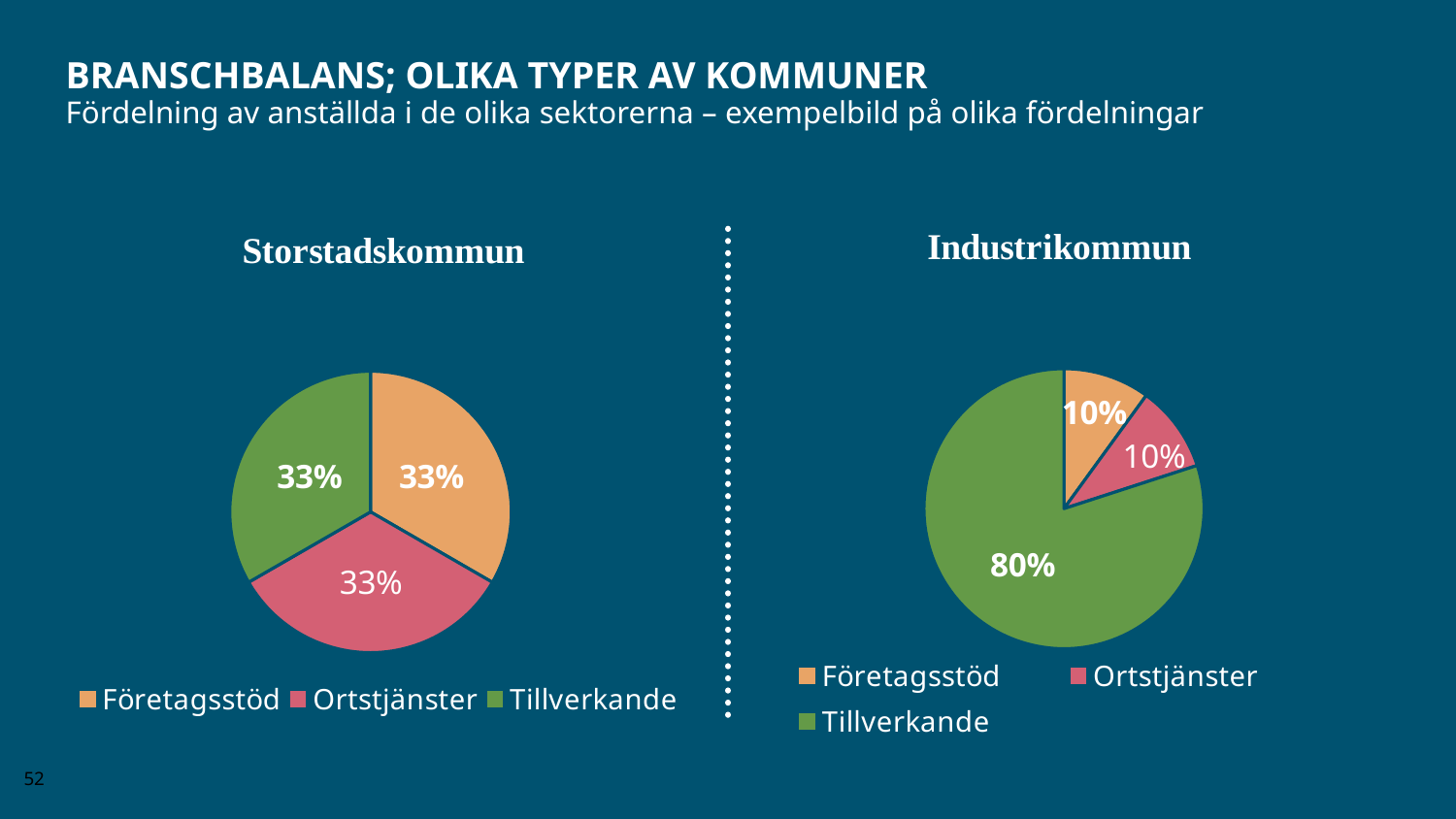
In the Storstadskommun chart, what share does Tillverkande have? 33% In the Industrikommun chart, which is larger, the share for Tillverkande or the share for Ortstjänster? Tillverkande In the Industrikommun chart, which colour represents Tillverkande? Green In the Industrikommun chart, which sector has the largest share? Tillverkande In the Industrikommun chart, what share does Ortstjänster have? 10% How many entries does the legend of the Storstadskommun chart list? 3 In the Industrikommun chart, what share does Företagsstöd have? 10% In the Industrikommun chart, what share does Tillverkande have? 80% In the Storstadskommun chart, what share does Företagsstöd have? 33% How many slices does the Industrikommun pie chart have? 3 In the Industrikommun chart, what is the difference between the Tillverkande share and the Företagsstöd share? 70% What kind of chart is the Storstadskommun chart? Pie chart